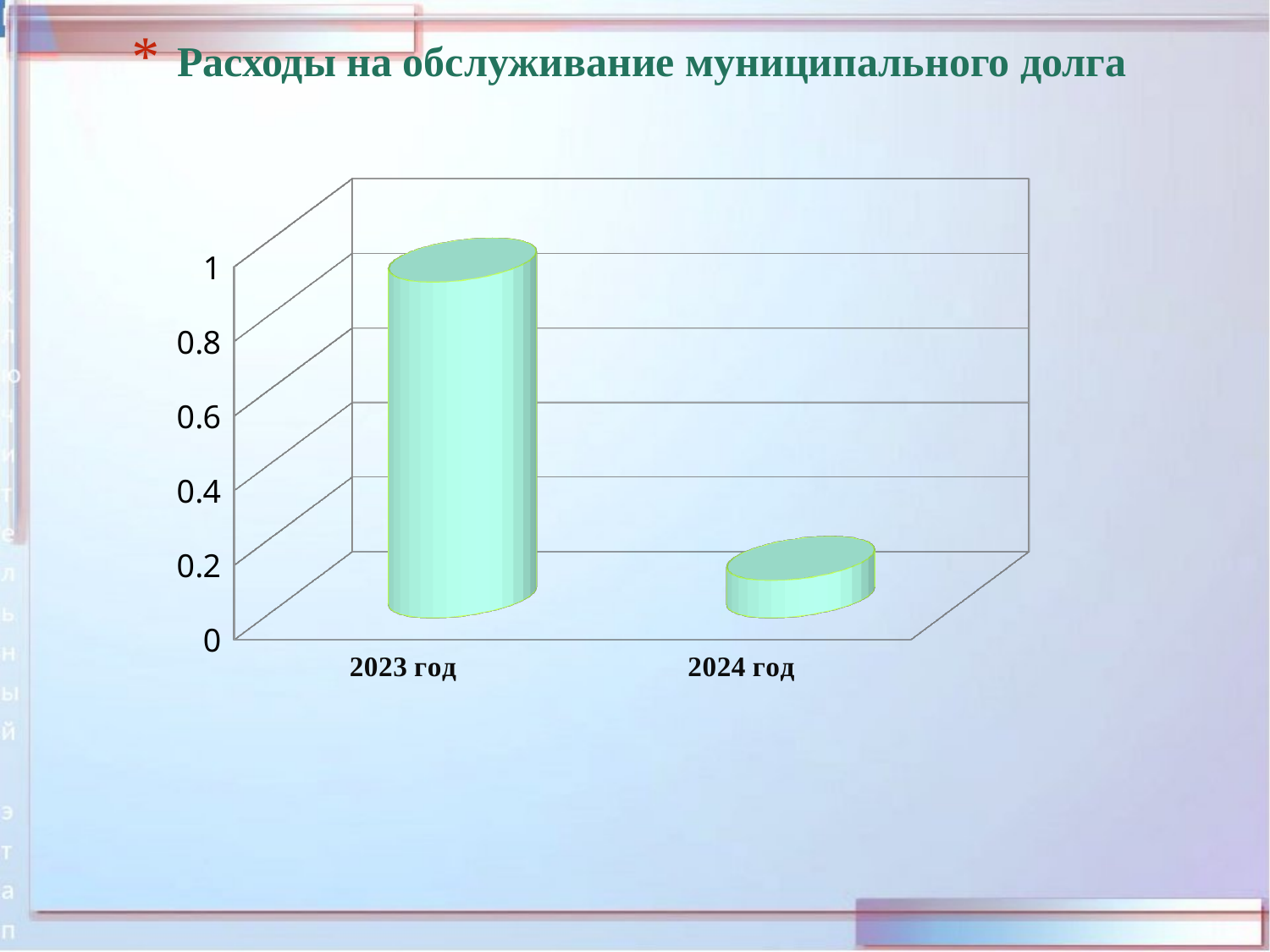
What is the highest tick value shown on the vertical axis of the chart? 1 Do the values rise or fall from 2023 год to 2024 год? fall Is the value for 2024 год greater or less than 0.4? less Which category has the lowest value in the chart? 2024 год Which is larger, the value for 2023 год or the value for 2024 год? 2023 год How many categories are shown on the x axis of the chart? 2 Is the value for 2023 год greater or less than 0.8? greater What is the title of the chart on the slide? Расходы на обслуживание муниципального долга Which category has the highest value in the chart? 2023 год What kind of chart is shown on the slide? bar chart Is the value for 2024 год greater or less than 0.2? less